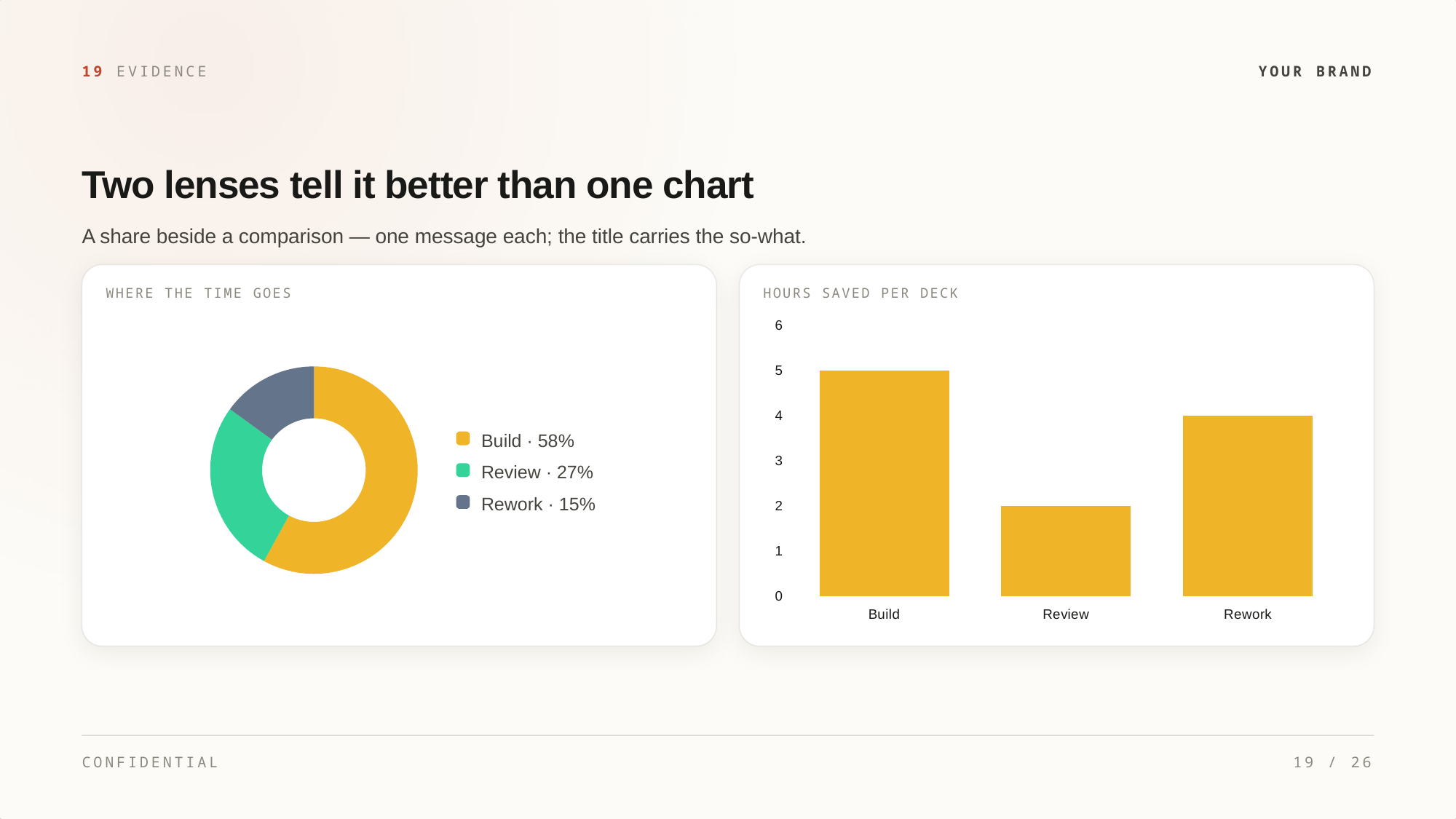
In the 'Hours saved per deck' chart, what is the difference between Build and Rework? 1 What kind of chart is 'Where the time goes'? Donut (pie) chart In the 'Hours saved per deck' chart, which category has the lowest value? Review In the 'Where the time goes' chart, which category has the smallest share? Rework How many categories are shown in the 'Hours saved per deck' chart? 3 In the 'Where the time goes' chart, which category has the largest share? Build In the 'Where the time goes' chart, how many percentage points larger is Review's share than Rework's? 12 In the 'Where the time goes' chart, what share does Rework account for? 15% In the 'Where the time goes' chart, what share does Build account for? 58% In the 'Hours saved per deck' chart, how many hours are saved for Build? 5 In the 'Hours saved per deck' chart, how many hours are saved for Review? 2 In the 'Hours saved per deck' chart, is the value for Rework greater or less than Review? greater